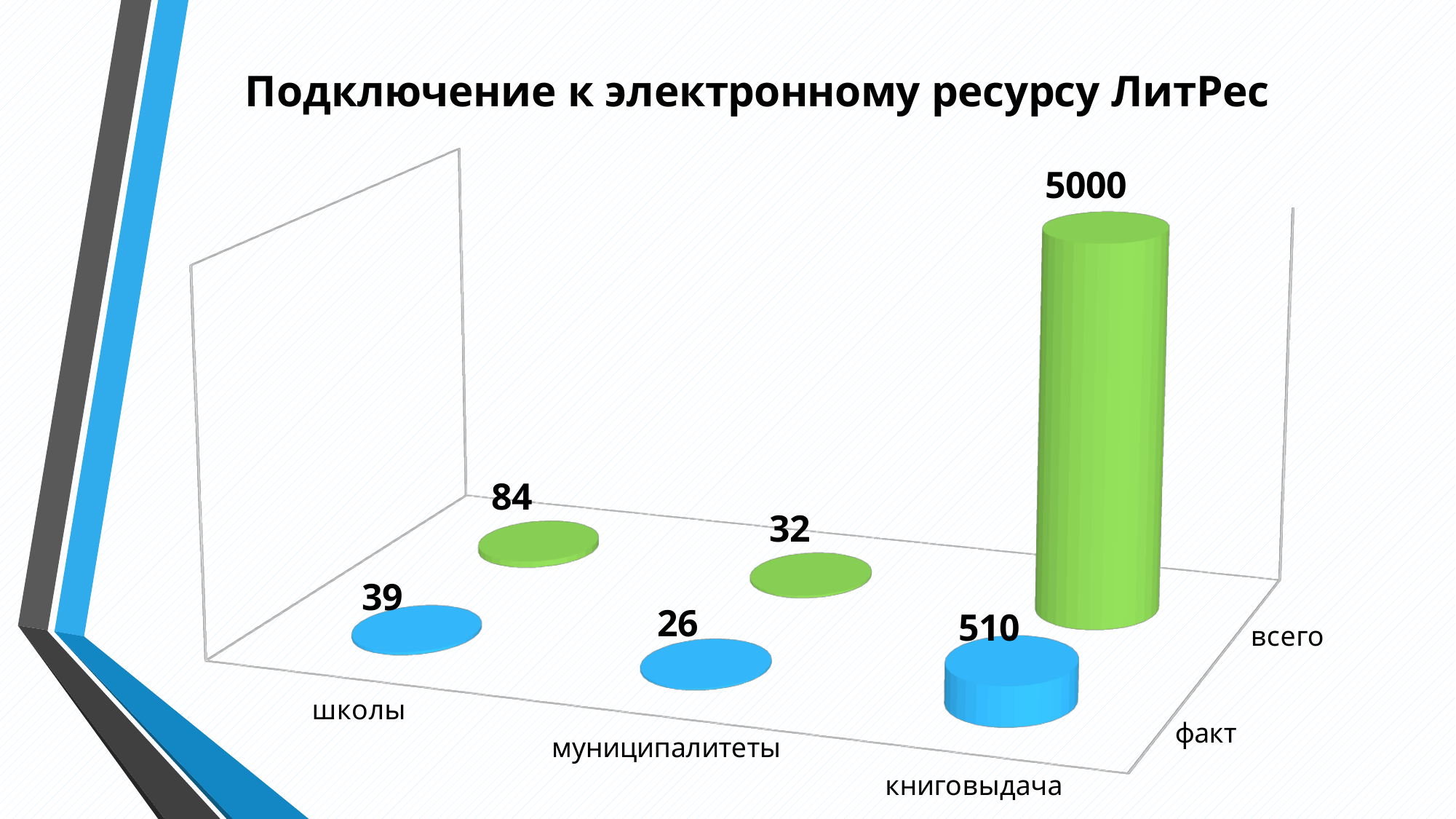
What is the value for книговыдача in the факт series? 510 What is the value for школы in the факт series? 39 What is the value for книговыдача in the всего series? 5000 What is the value for муниципалитеты in the факт series? 26 What is the value for школы in the всего series? 84 What is the difference between the всего and факт values for школы? 45 What is the value for муниципалитеты in the всего series? 32 How many categories are shown on the chart? 3 Which is larger for книговыдача: the факт value or the всего value? всего What is the title of the chart? Подключение к электронному ресурсу ЛитРес Which category has the lowest value in the факт series? муниципалитеты Which category has the highest value in the всего series? книговыдача